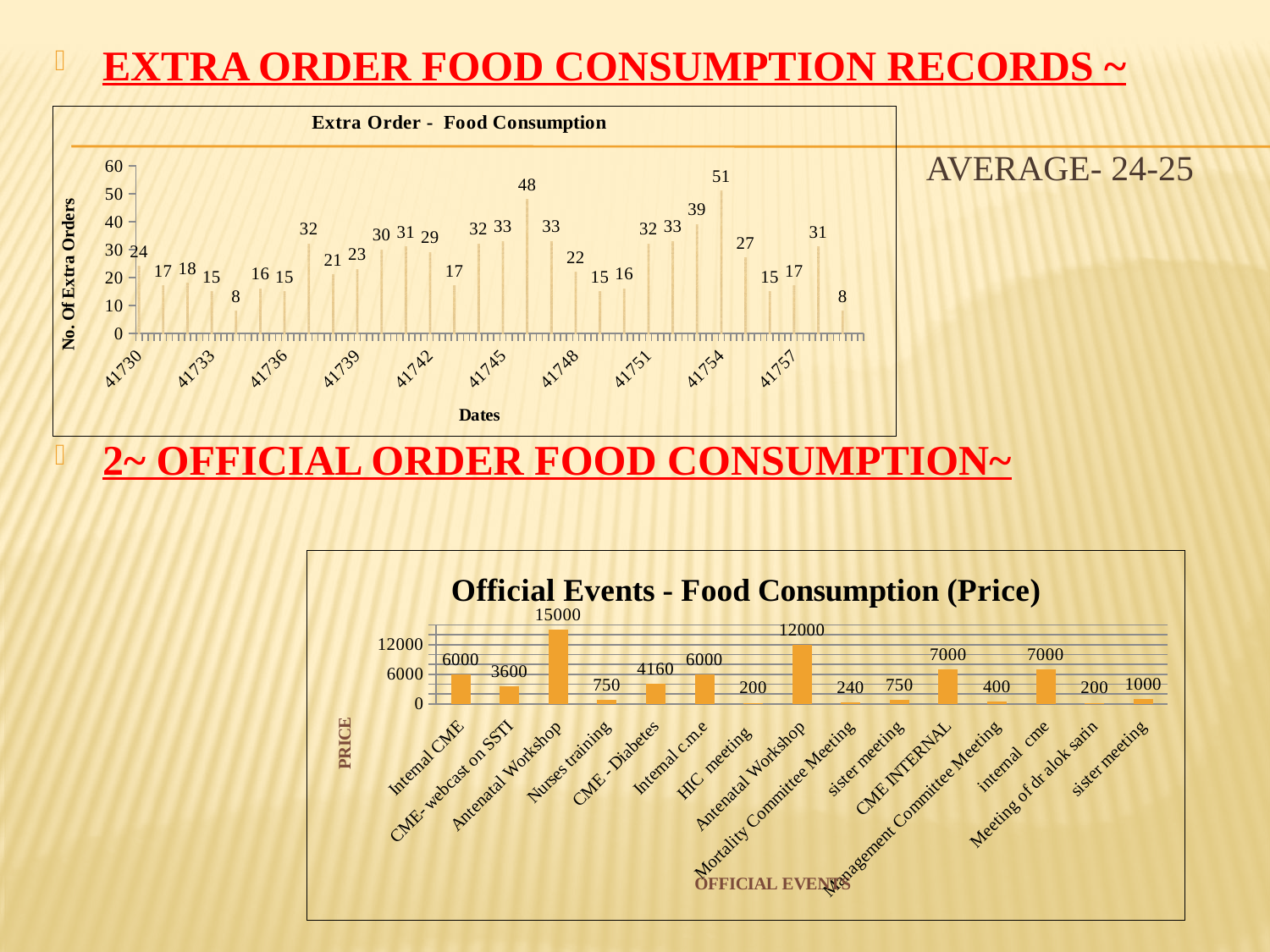
In the 'Extra Order - Food Consumption' chart, what is the lowest value shown? 8 In the 'Extra Order - Food Consumption' chart, what is the highest value shown? 51 In the 'Official Events - Food Consumption (Price)' chart, what is the value for HIC meeting? 200 In the 'Official Events - Food Consumption (Price)' chart, what is the highest value shown? 15000 In the 'Official Events - Food Consumption (Price)' chart, what is the value for CME - Diabetes? 4160 In the 'Official Events - Food Consumption (Price)' chart, which is larger: the value for CME INTERNAL or the value for CME - Diabetes? CME INTERNAL How many categories are plotted in the 'Official Events - Food Consumption (Price)' chart? 15 In the 'Official Events - Food Consumption (Price)' chart, what is the difference between the value for Internal CME and the value for CME-webcast on SSTI? 2400 In the 'Official Events - Food Consumption (Price)' chart, what is the value for CME-webcast on SSTI? 3600 What is the y-axis title of the 'Extra Order - Food Consumption' chart? No. Of Extra Orders What kind of chart is the 'Official Events - Food Consumption (Price)' chart? bar chart In the 'Official Events - Food Consumption (Price)' chart, what is the value for Nurses training? 750